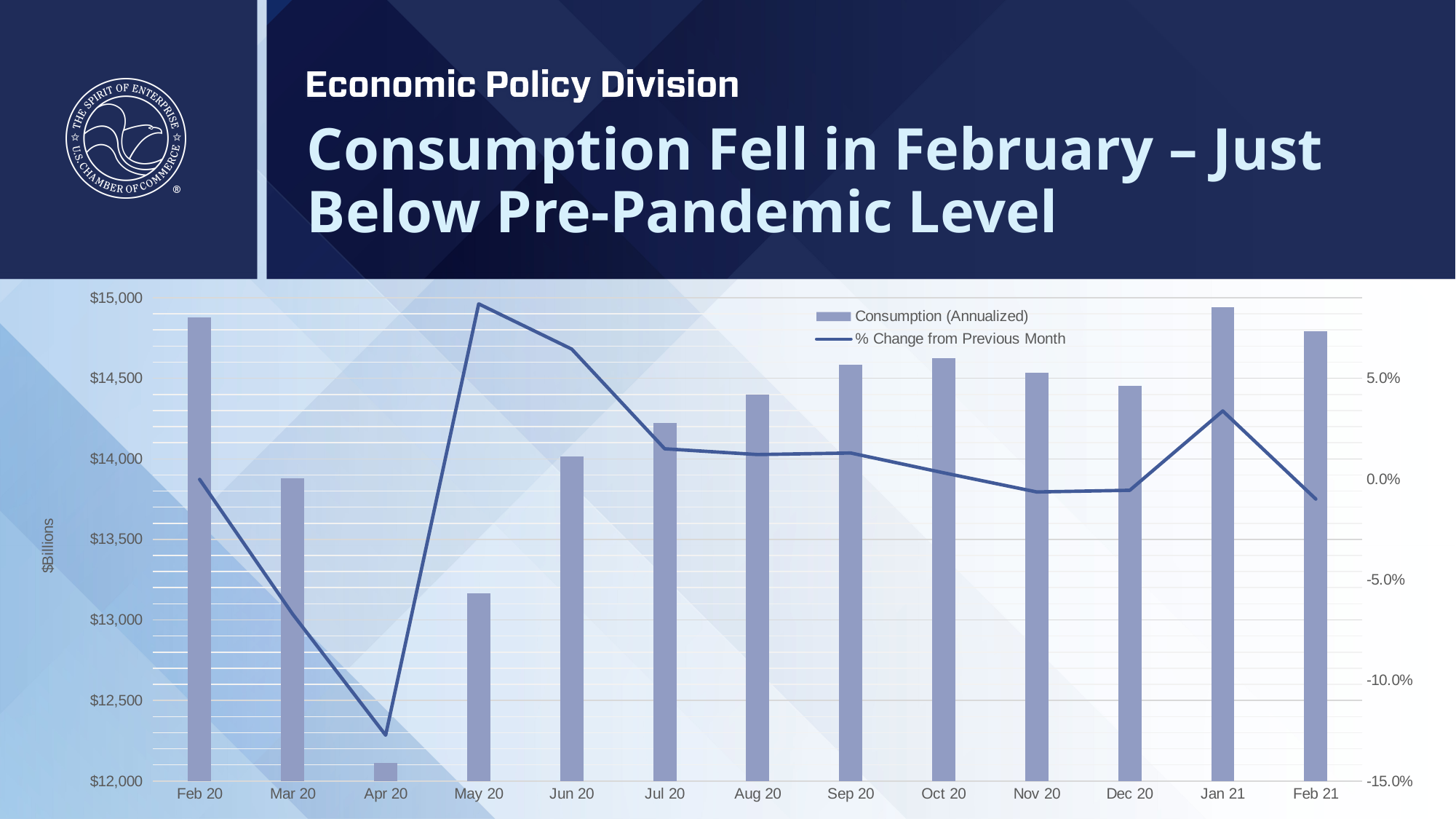
Which month has the higher Consumption (Annualized) bar, Aug 20 or Sep 20? Sep 20 What is the label on the left vertical axis of the chart? $Billions In which month does the % Change from Previous Month line reach its lowest point? Apr 20 How many series does the chart's legend list? 2 How many months are shown on the x axis of the chart? 13 Do the Consumption (Annualized) bars rise or fall from Apr 20 to Oct 20? rise Is the % Change from Previous Month value for Apr 20 greater or less than -10.0%? less What kind of chart is shown on the slide? A combined bar and line chart Is the Consumption (Annualized) value for Jul 20 greater or less than $14,000? greater Is the Consumption (Annualized) value for Apr 20 greater or less than $12,500? less In which month does the % Change from Previous Month line reach its highest point? May 20 Which month has the lowest Consumption (Annualized) bar? Apr 20